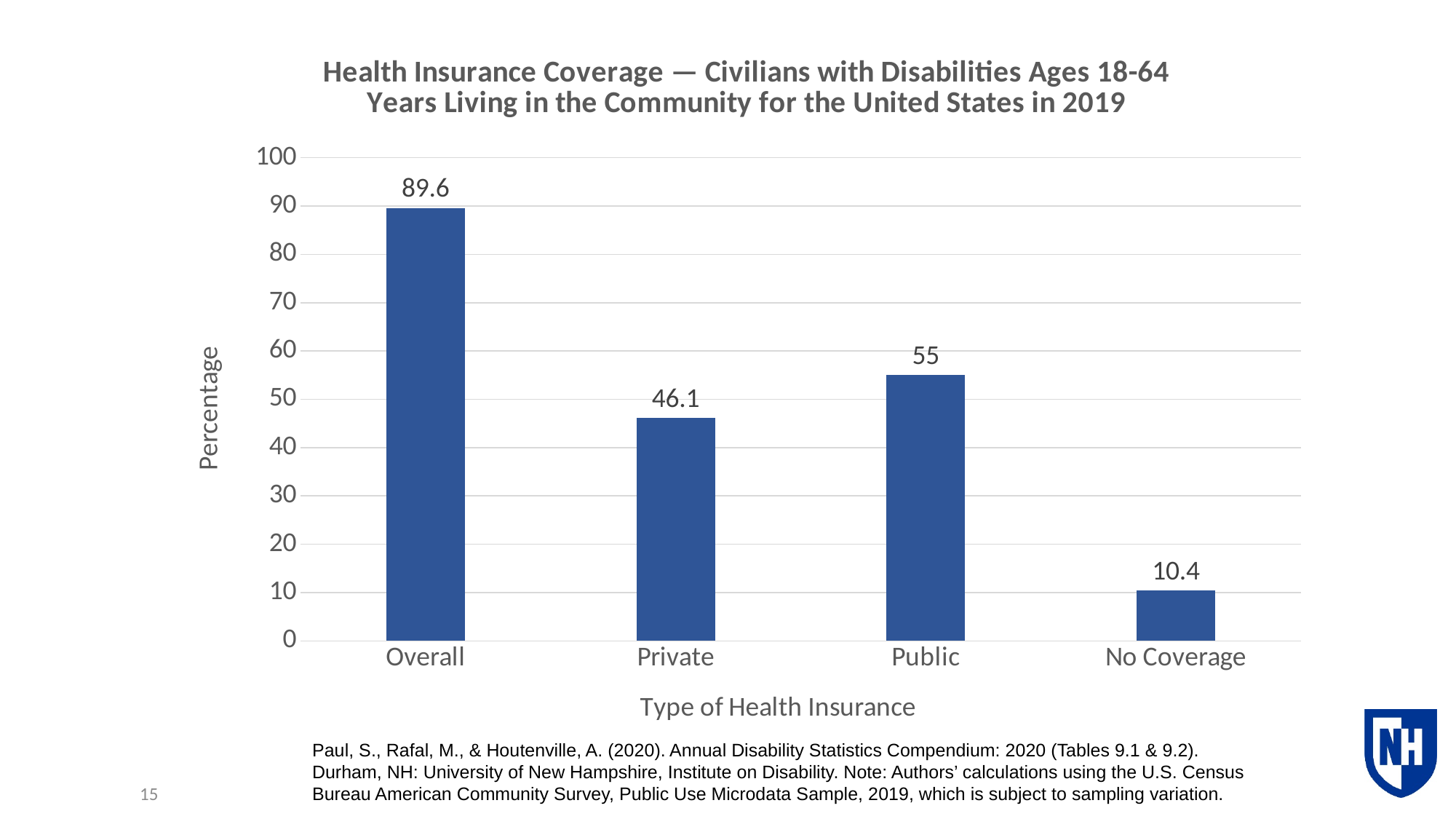
What kind of chart is shown on the slide? Bar chart What is the value for Private? 46.1 Which is larger, the value for Private or the value for Public? Public How many categories are shown on the x axis? 4 What is the value for Public? 55 Which category has the lowest value? No Coverage What is the difference between the values for Public and Private? 8.9 What is the label of the y axis? Percentage What is the difference between the values for Overall and No Coverage? 79.2 What is the value for Overall? 89.6 Which type of health insurance has the highest value? Overall What is the value for No Coverage? 10.4